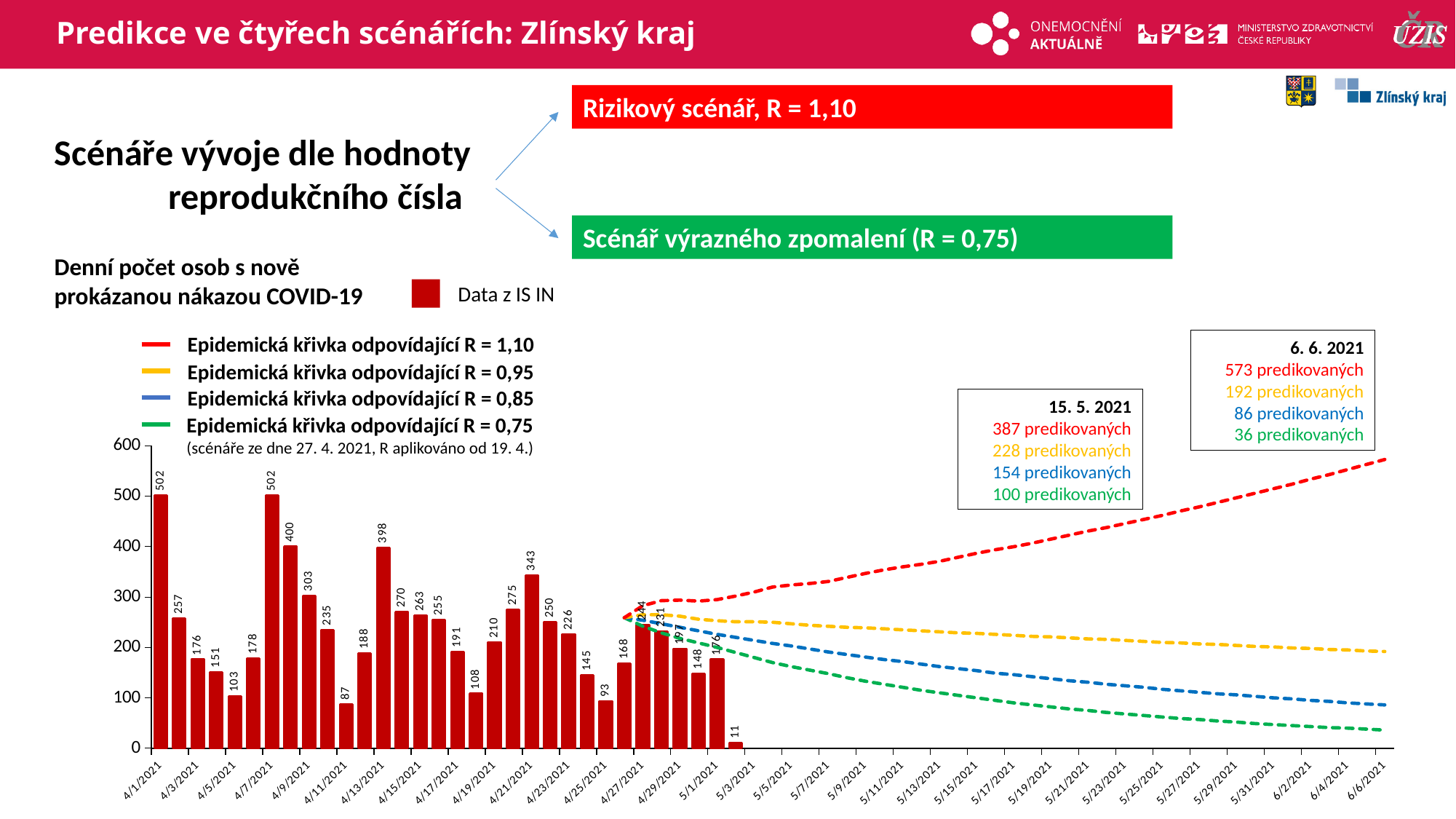
How many epidemic curves (Epidemická křivka) are listed in the legend? 4 Which date has the larger bar value, 4/9/2021 or 4/21/2021? 4/21/2021 Does the red dashed curve rise or fall from 5/3/2021 to 6/6/2021? rises Is the green dashed curve (R = 0,75) at 5/15/2021 greater or less than 200? less What is the value of the bar for 4/21/2021? 343 What kind of chart is used to show the daily data from IS IN? bar chart What is the highest daily value labelled on any bar in the chart? 502 What is the daily number of newly confirmed COVID-19 cases shown for 4/13/2021? 398 How many predicted cases does the R = 1,10 scenario give for 6. 6. 2021? 573 predikovaných What is the lowest value labelled on any bar in the chart? 11 How many predicted cases does the R = 0,75 scenario give for 15. 5. 2021? 100 predikovaných What is the difference between the bar values for 4/13/2021 and 4/11/2021? 311